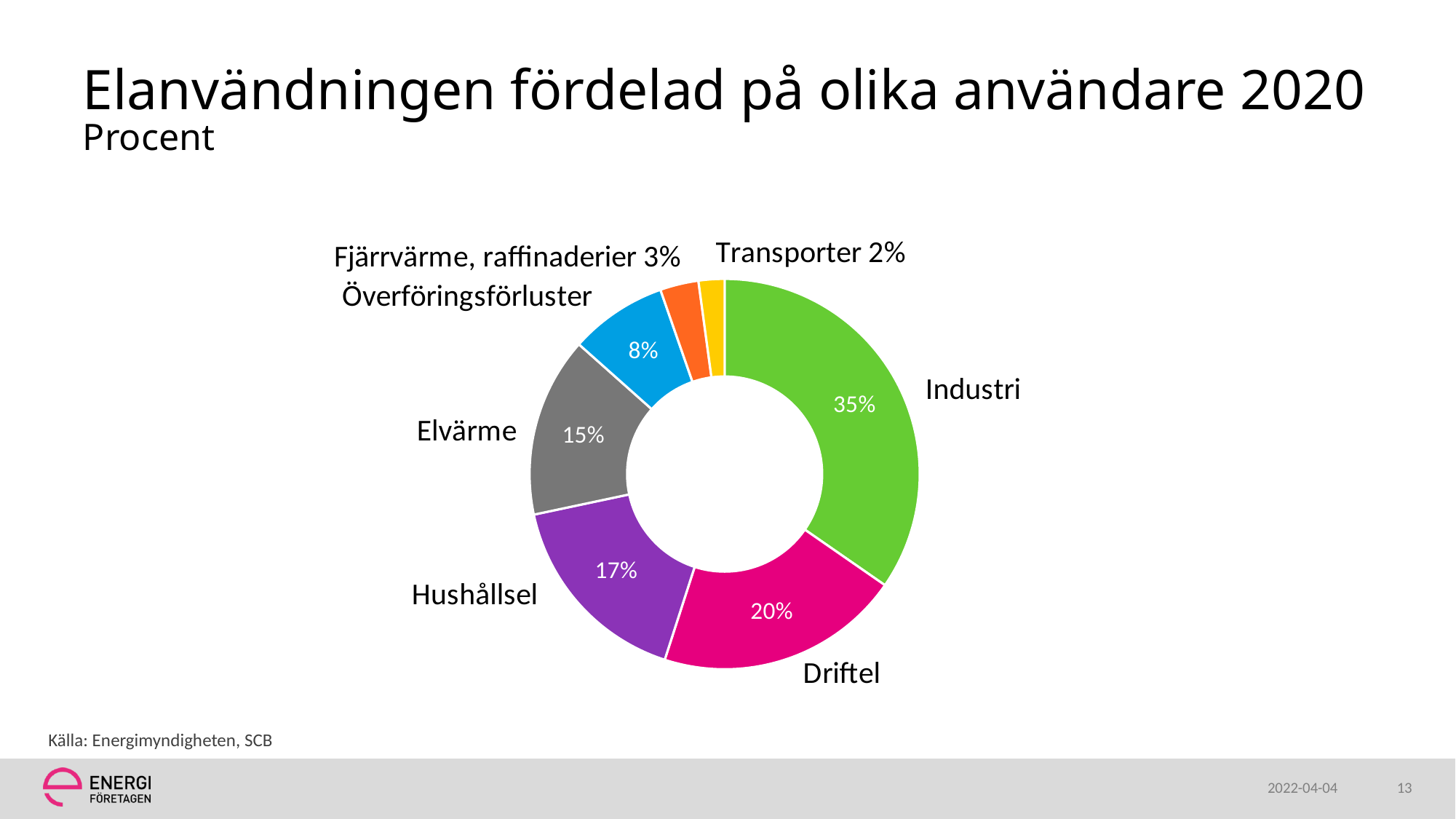
What percentage is shown for Driftel? 20% Which is larger, the share for Hushållsel or the share for Elvärme? Hushållsel What share of electricity use does Industri account for? 35% What percentage is shown for Elvärme? 15% Which category has the smallest share of the chart? Transporter How many categories are shown in the chart? 7 What is the difference in percentage points between Industri and Driftel? 15 What percentage is shown for Hushållsel? 17% What type of chart is shown on the slide? Pie chart (donut) Which category has the largest share of the chart? Industri What percentage is shown for Överföringsförluster? 8% What percentage is shown for Transporter? 2%